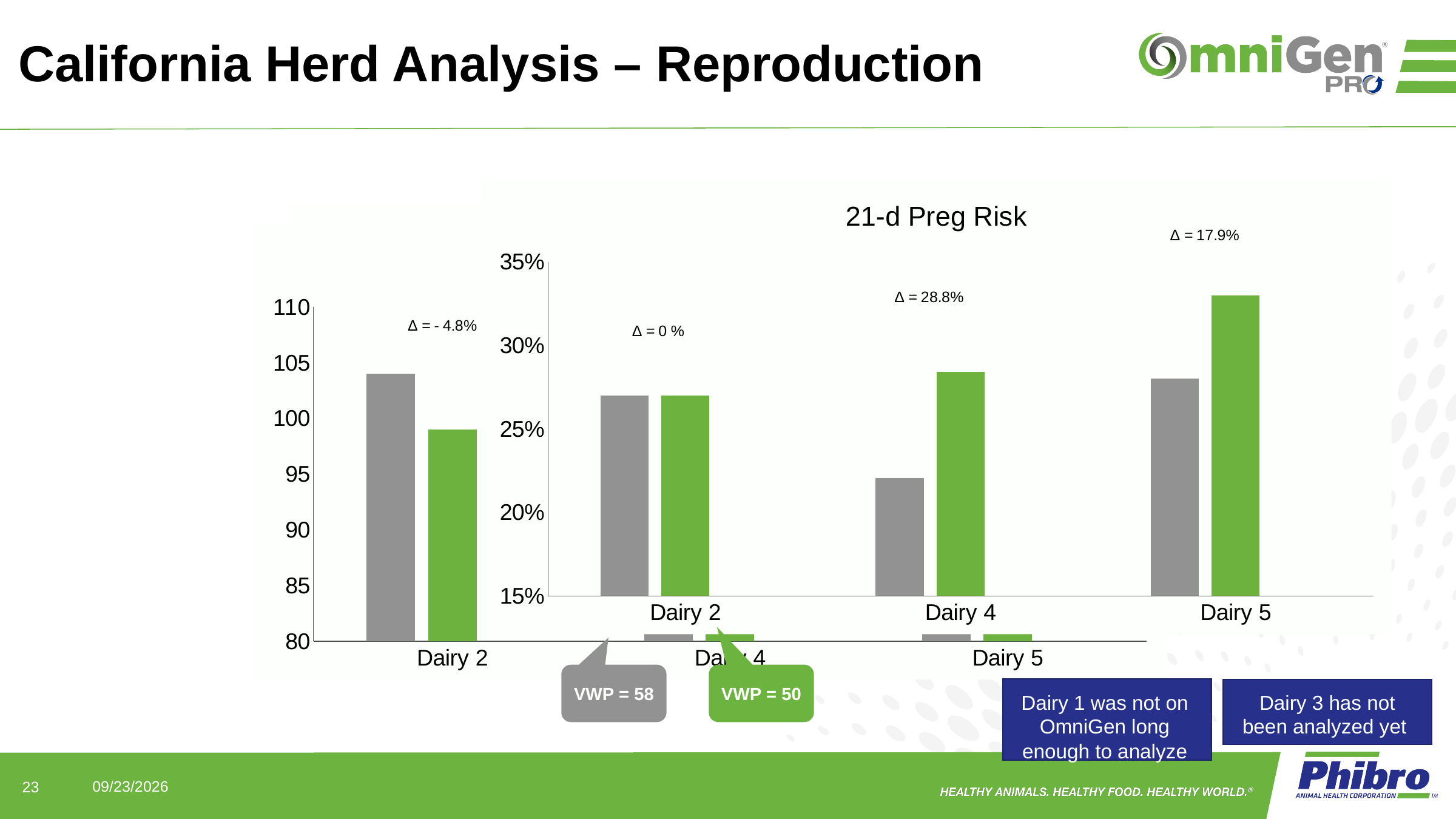
What kind of chart is the 21-d Preg Risk chart? bar chart In the 21-d Preg Risk chart, what Δ value is shown above Dairy 5? Δ = 17.9% In the 21-d Preg Risk chart, is the gray bar for Dairy 2 greater or less than 25%? greater In the 21-d Preg Risk chart, how many dairies are shown on the x axis? 3 In the 21-d Preg Risk chart, which bar is taller for Dairy 4, the gray bar or the green bar? the green bar In the 21-d Preg Risk chart, what Δ value is shown above Dairy 4? Δ = 28.8% In the 21-d Preg Risk chart, which dairy has the shortest gray bar? Dairy 4 In the 21-d Preg Risk chart, is the green bar for Dairy 5 greater or less than 30%? greater What is the title of the chart on the right side of the slide? 21-d Preg Risk In the 21-d Preg Risk chart, is the gray bar for Dairy 4 greater or less than 25%? less In the 21-d Preg Risk chart, which dairy has the tallest green bar? Dairy 5